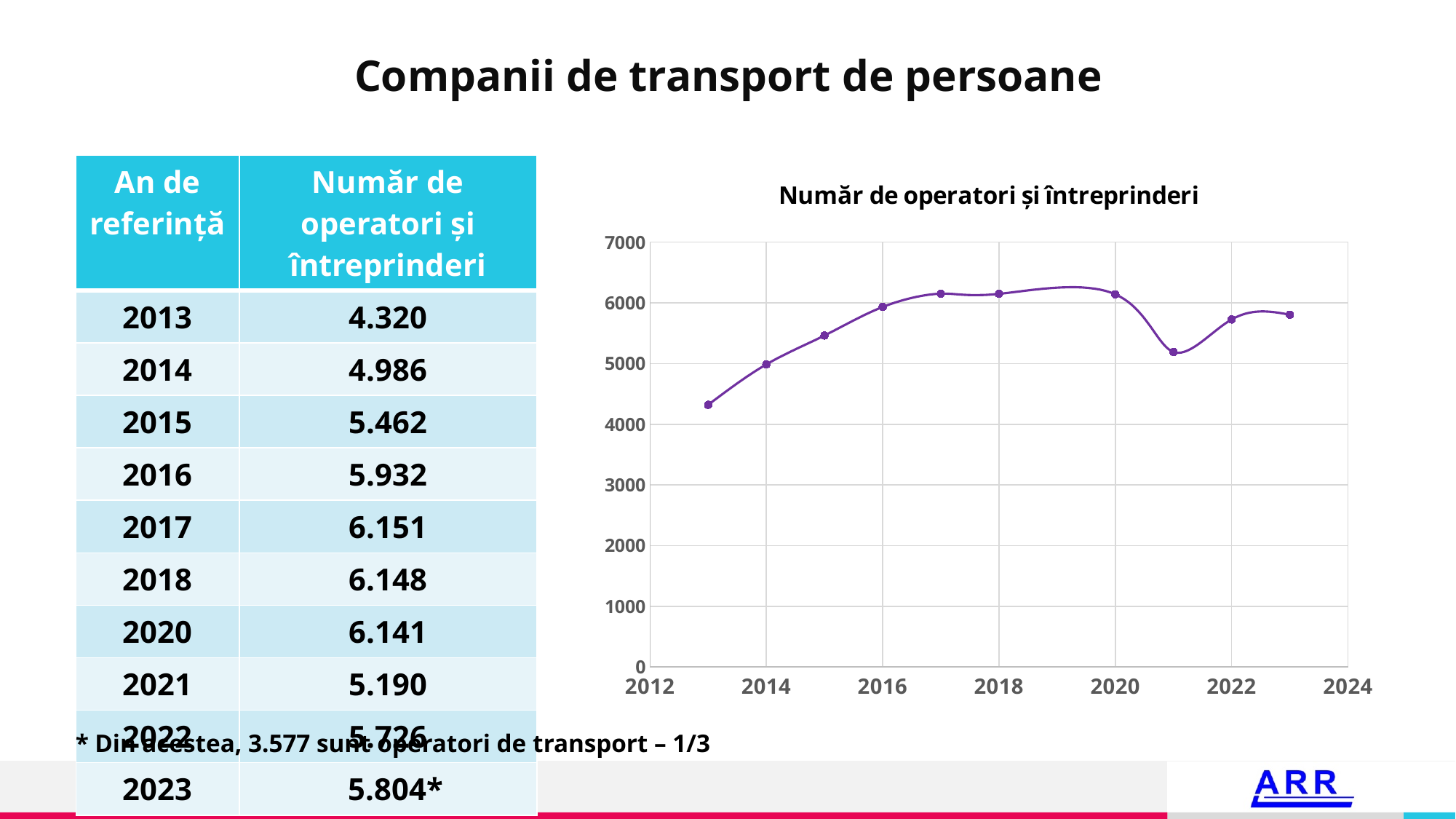
What is the title of the chart? Număr de operatori și întreprinderi How many data points are plotted on the line chart? 10 Which is larger, the value for 2016 or the value for 2021? 2016 Is the value for 2017 greater or less than 6000? greater What is the difference between the values for 2014 and 2013? 666 What kind of chart is shown on the slide? line chart Is the value for 2013 greater or less than 5000? less What is the number of operators and enterprises for 2021? 5.190 Which year has the lowest number of operators and enterprises? 2013 Is the value for 2023 greater or less than 6000? less What is the number of operators and enterprises for 2013? 4.320 What is the number of operators and enterprises for 2017? 6.151